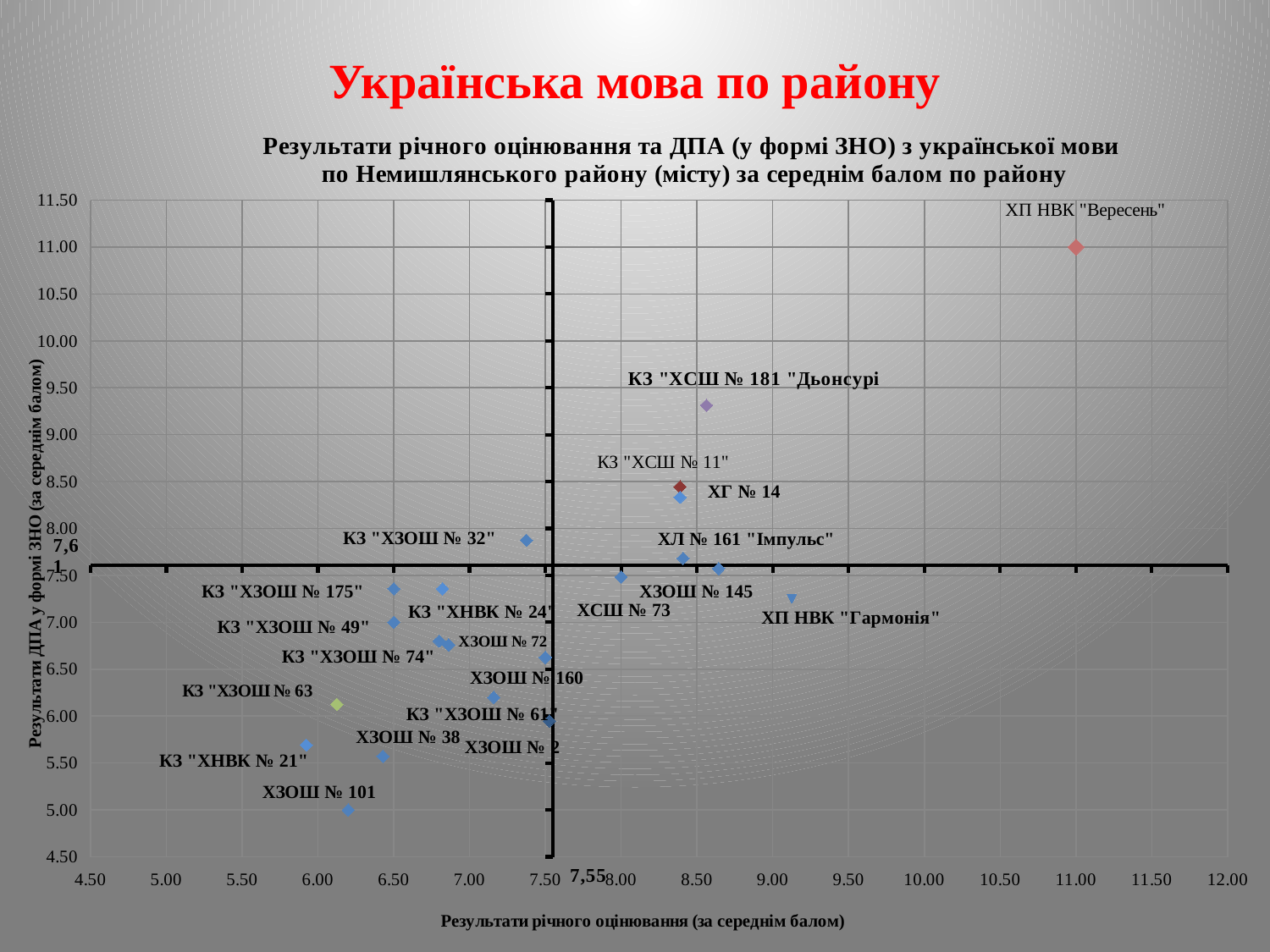
Which school has the highest value on the vertical axis (ДПА result)? ХП НВК "Вересень" What kind of chart is shown on the slide? scatter chart What is the label of the horizontal axis of the chart? Результати річного оцінювання (за середнім балом) Which has the higher vertical-axis value: КЗ "ХНВК № 21" or ХЗОШ № 101? КЗ "ХНВК № 21" What value is printed on the horizontal axis where the vertical reference line crosses it? 7,55 Is the vertical-axis value for КЗ "ХСШ № 181 "Дьонсурі" greater or less than 9.00? greater Which school has the lowest value on the vertical axis (ДПА result)? ХЗОШ № 101 Is the vertical-axis value for ХП НВК "Вересень" greater or less than 10.50? greater Which has the higher horizontal-axis value: ХП НВК "Гармонія" or КЗ "ХЗОШ № 63"? ХП НВК "Гармонія" Which has the higher vertical-axis value: ХП НВК "Вересень" or КЗ "ХСШ № 181 "Дьонсурі"? ХП НВК "Вересень" Is the vertical-axis value for ХЗОШ № 101 greater or less than 5.50? less